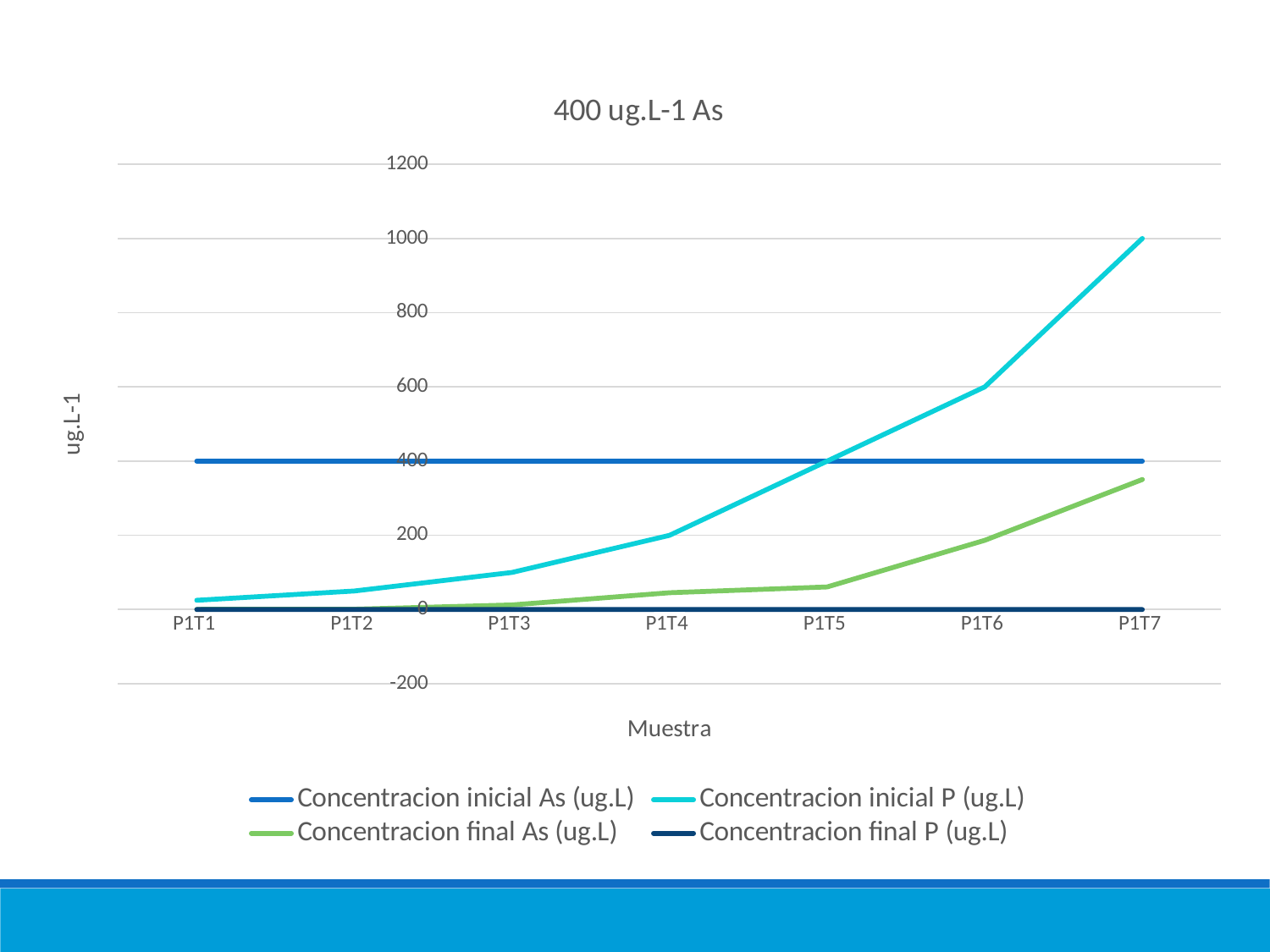
What is the title of the chart? 400 ug.L-1 As At P1T7, which is larger: Concentracion inicial P (ug.L) or Concentracion final As (ug.L)? Concentracion inicial P (ug.L) Does Concentracion inicial P (ug.L) rise or fall from P1T1 to P1T7? rise What is the label of the x axis? Muestra What is the value of Concentracion inicial As (ug.L) at P1T3? 400 Is the value for Concentracion final As (ug.L) at P1T7 greater or less than 200? greater What kind of chart is shown on the slide? line chart What is the value of Concentracion inicial P (ug.L) at P1T6? 600 How many categories are shown on the x axis? 7 Is the value for Concentracion inicial P (ug.L) at P1T3 greater or less than 200? less How many series does the legend list? 4 What is the value of Concentracion inicial P (ug.L) at P1T7? 1000